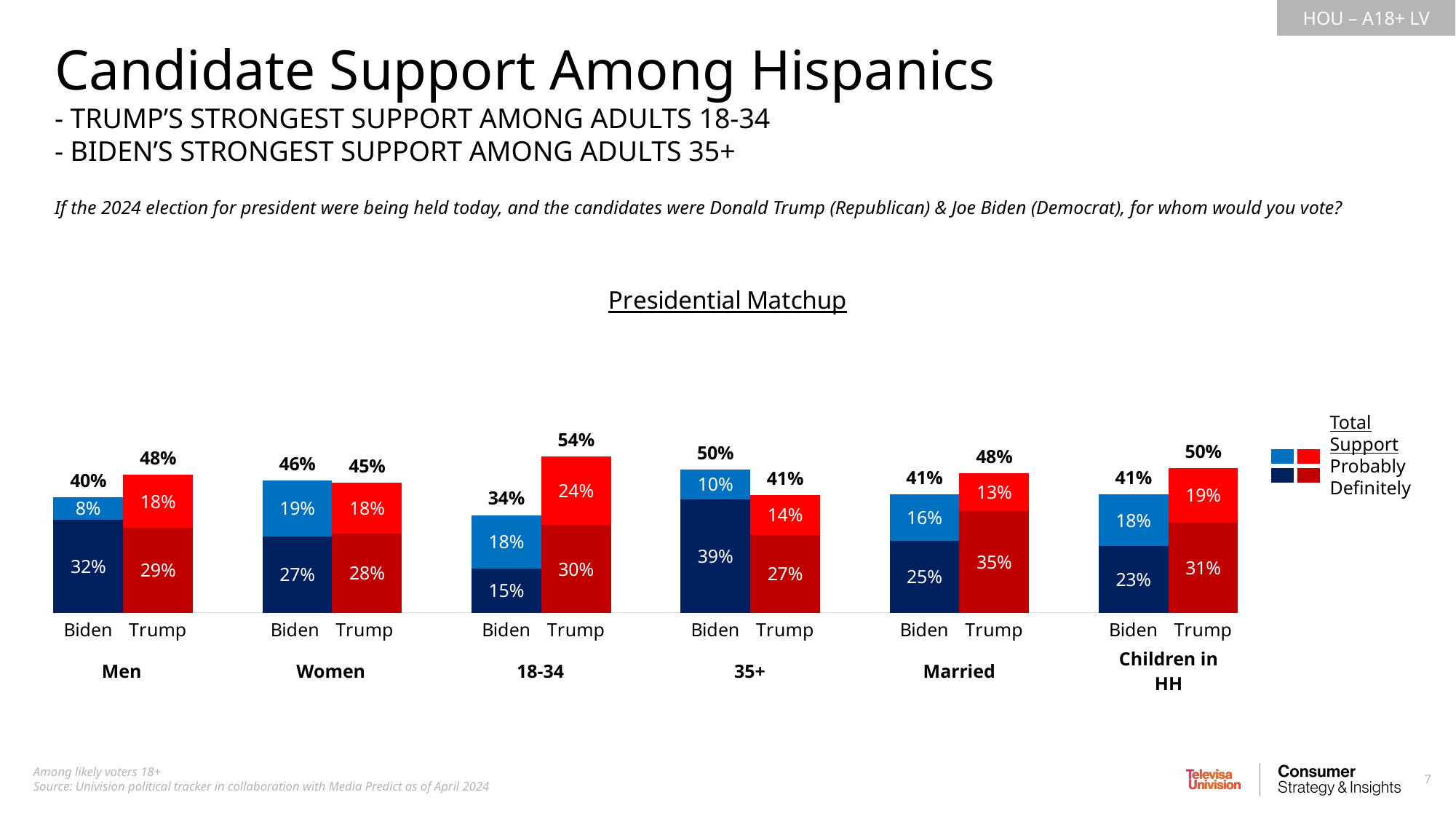
What kind of chart is shown on the slide? Stacked bar chart What two support levels does the legend distinguish? Probably and Definitely How many demographic groups are shown in the chart? 6 Which demographic group shows the lowest total support for Biden? 18-34 What is the 'Probably' support for Trump among adults 18-34? 24% Among Women, who has higher total support, Biden or Trump? Biden What is the title of the chart? Presidential Matchup What is the difference between Biden's and Trump's total support among adults 35+? 9 percentage points Which demographic group shows the highest total support for Trump? 18-34 What is the total support for Trump among Men? 48% What is the 'Definitely' support for Biden among adults 35+? 39% What is the total of the Biden bar for Married (Probably plus Definitely)? 41%